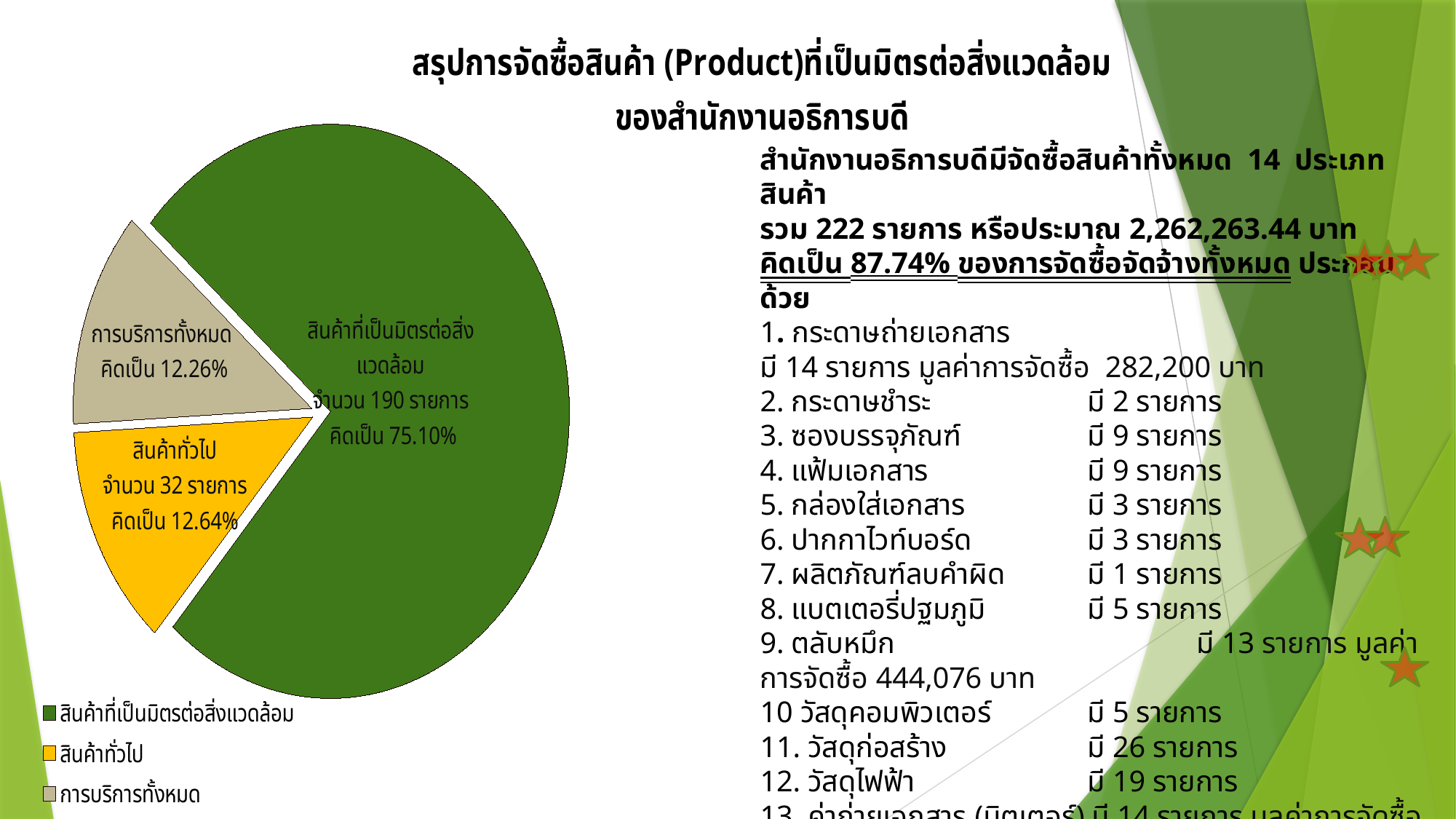
What share of the pie does การบริการทั้งหมด represent? 12.26% What share of the pie does สินค้าทั่วไป represent? 12.64% Which slice of the pie chart is the largest? สินค้าที่เป็นมิตรต่อสิ่งแวดล้อม How many รายการ are shown for สินค้าทั่วไป in the pie chart? 32 รายการ What is the difference in percentage points between the share of สินค้าทั่วไป and the share of การบริการทั้งหมด? 0.38% How many entries does the legend of the pie chart list? 3 How many รายการ are shown for สินค้าที่เป็นมิตรต่อสิ่งแวดล้อม in the pie chart? 190 รายการ Which has the larger share according to the labels, สินค้าทั่วไป or การบริการทั้งหมด? สินค้าทั่วไป How many slices does the pie chart have? 3 What colour is the สินค้าทั่วไป slice in the pie chart? yellow What kind of chart is shown on the slide? pie chart What share of the pie does สินค้าที่เป็นมิตรต่อสิ่งแวดล้อม represent? 75.10%